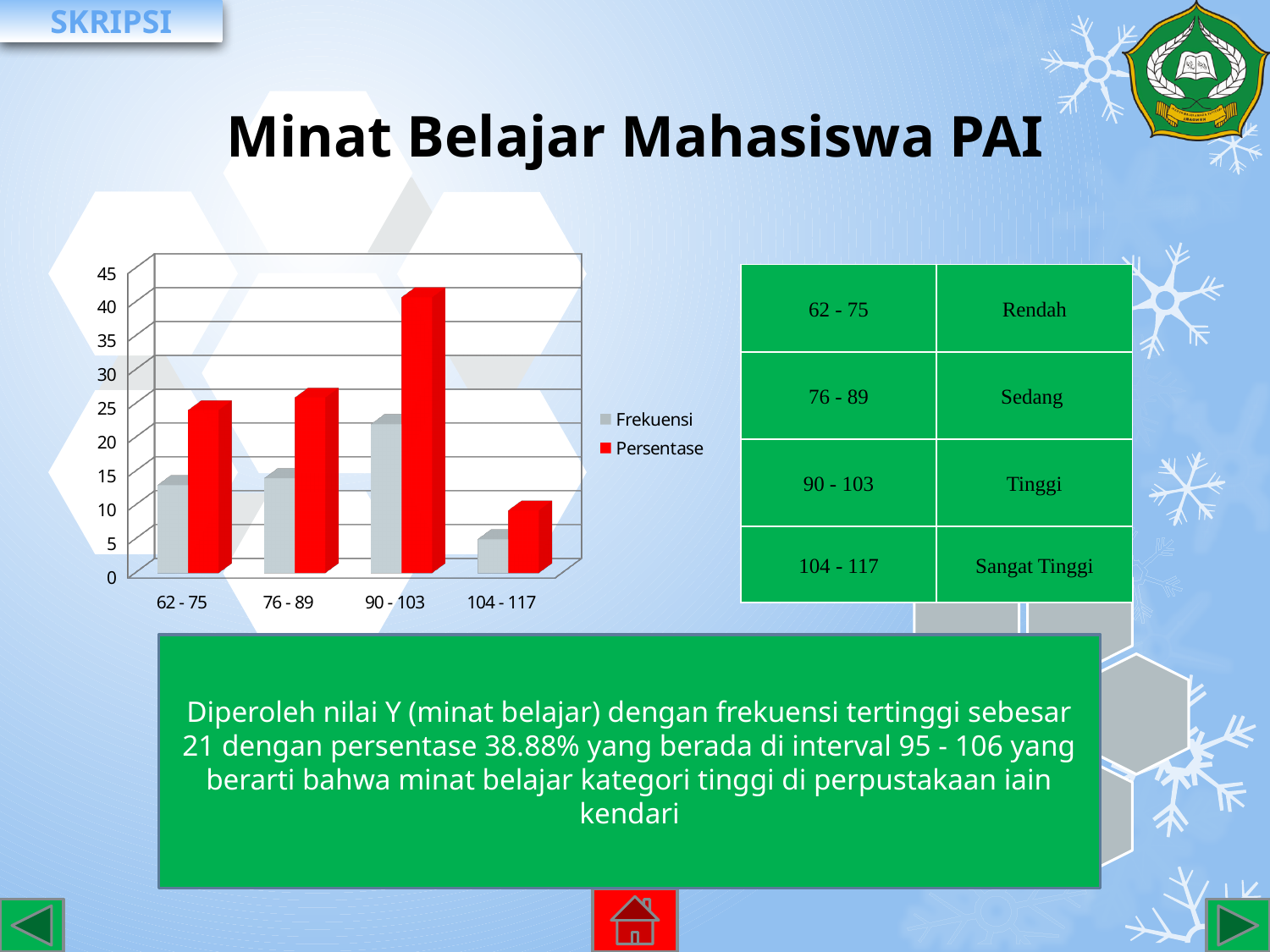
How many series does the chart legend list? 2 Which category has the lowest Persentase value? 104 - 117 How many categories are shown on the x axis of the chart? 4 Which category has the lowest Frekuensi value? 104 - 117 Is the Persentase value for 76 - 89 greater or less than 20? greater What kind of chart is shown on the slide? bar chart Is the Persentase value for 90 - 103 greater or less than 35? greater What colour are the Persentase bars in the chart? red Which category has the highest Frekuensi value? 90 - 103 Which is larger for the 90 - 103 category, Frekuensi or Persentase? Persentase Is the Frekuensi value for 104 - 117 greater or less than 10? less Which category has the highest Persentase value? 90 - 103